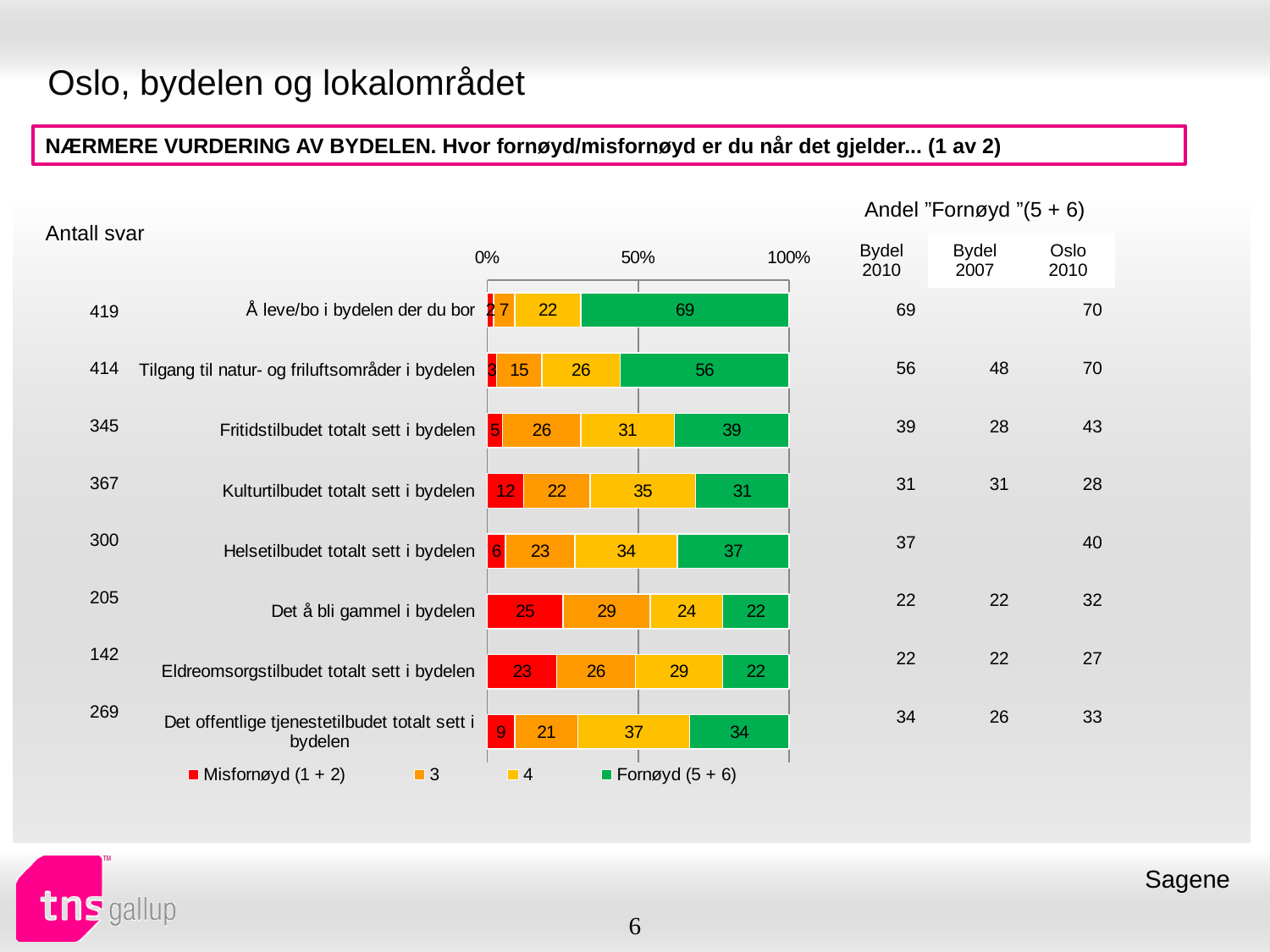
What type of chart is shown on the slide? Stacked bar chart Which category has the highest Fornøyd (5 + 6) value? Å leve/bo i bydelen der du bor Which is larger: the Fornøyd (5 + 6) value for "Helsetilbudet totalt sett i bydelen" or for "Kulturtilbudet totalt sett i bydelen"? Helsetilbudet totalt sett i bydelen What is the Fornøyd (5 + 6) value for "Å leve/bo i bydelen der du bor"? 69 What is the difference between the Fornøyd (5 + 6) values for "Tilgang til natur- og friluftsområder i bydelen" and "Fritidstilbudet totalt sett i bydelen"? 17 How many series does the chart legend list? 4 What is the total of the stacked bar for "Kulturtilbudet totalt sett i bydelen"? 100 What is the value of series "4" for "Det offentlige tjenestetilbudet totalt sett i bydelen"? 37 How many categories are shown in the stacked bar chart? 8 What is the Misfornøyd (1 + 2) value for "Det å bli gammel i bydelen"? 25 Which category has the highest Misfornøyd (1 + 2) value? Det å bli gammel i bydelen Which category has the lowest Misfornøyd (1 + 2) value? Å leve/bo i bydelen der du bor